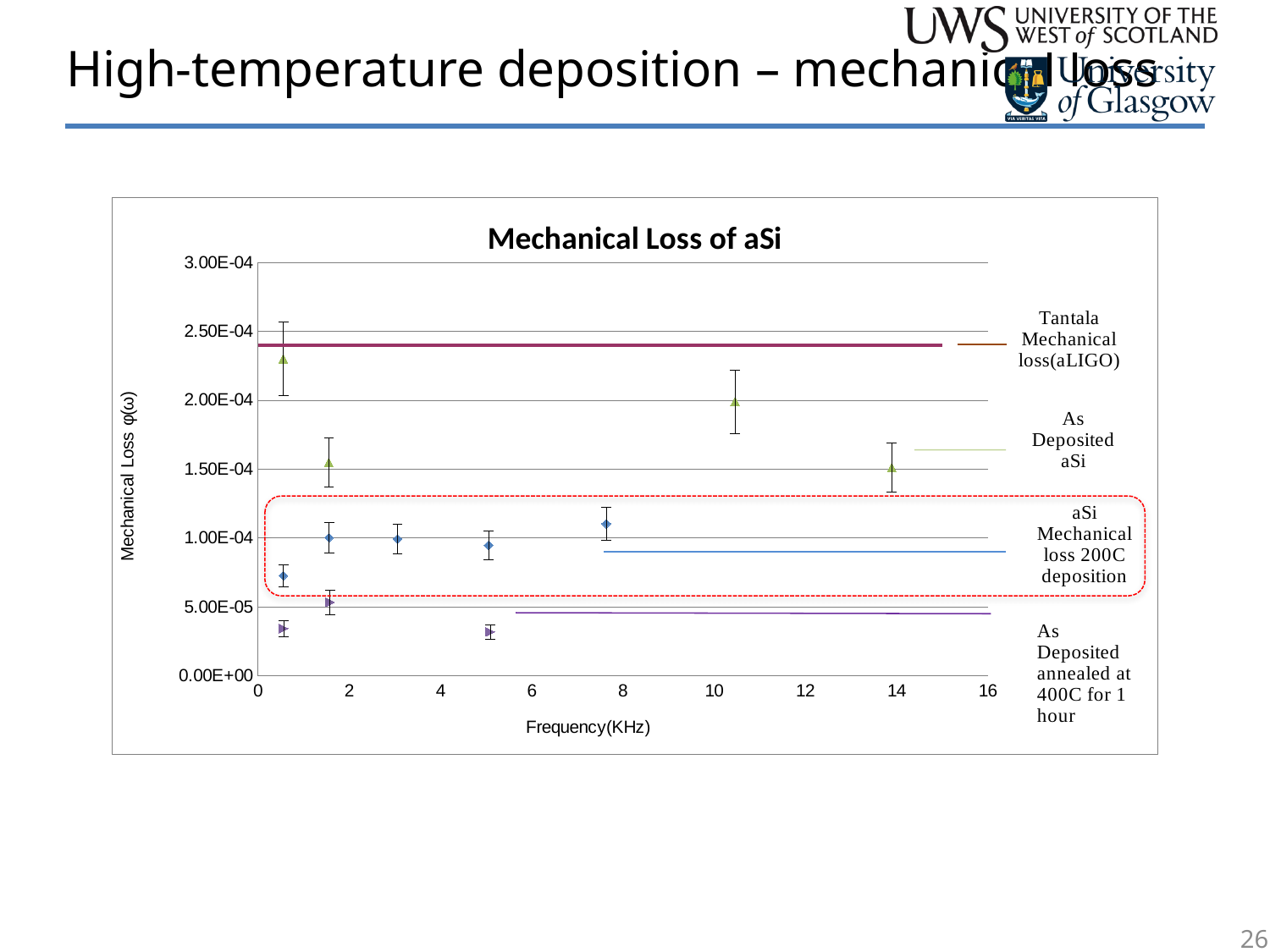
Is the Tantala Mechanical loss(aLIGO) line greater or less than 2.00E-04? greater Is the As Deposited annealed at 400C for 1 hour value near 5 KHz greater or less than 5.00E-05? less How many series does the chart legend list? 4 What is the label of the x axis? Frequency(KHz) What kind of chart is shown on the slide? scatter chart Which series has the lowest mechanical loss values on the chart? As Deposited annealed at 400C for 1 hour Near 1.5 KHz, which is larger: the As Deposited aSi value or the aSi Mechanical loss 200C deposition value? As Deposited aSi Is the aSi Mechanical loss 200C deposition value at the lowest frequency (near 0.5 KHz) greater or less than 1.00E-04? less What is the title of the chart? Mechanical Loss of aSi How many data points are plotted for the aSi Mechanical loss 200C deposition series? 5 Which series has the highest mechanical loss values on the chart? Tantala Mechanical loss(aLIGO)